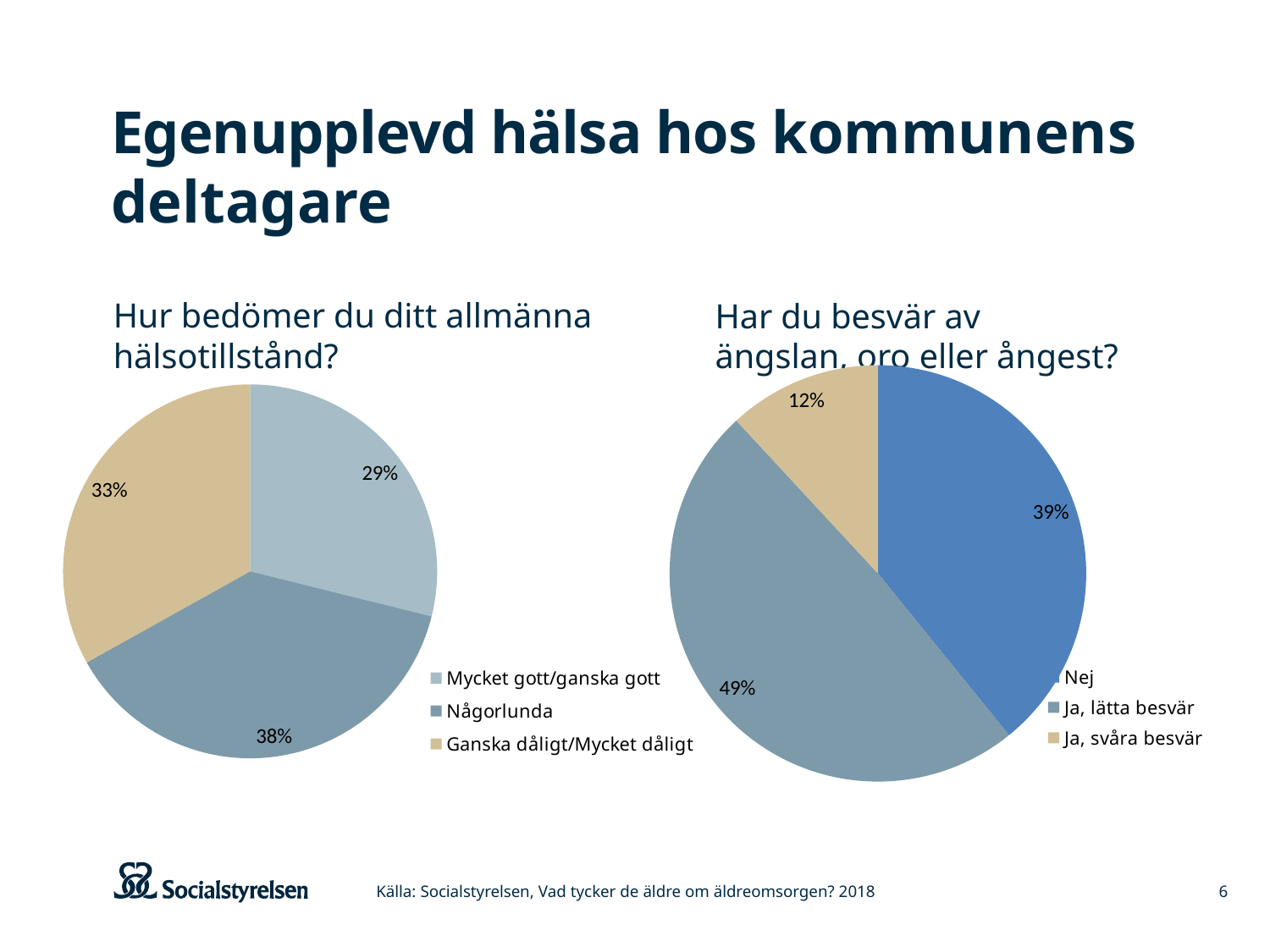
In the right chart (Har du besvär av ängslan, oro eller ångest?), what share of respondents answered Nej? 39% In the left chart (Hur bedömer du ditt allmänna hälsotillstånd?), what share of respondents answered Någorlunda? 38% In the right chart (Har du besvär av ängslan, oro eller ångest?), which is larger: the share for Nej or the share for Ja, lätta besvär? Ja, lätta besvär In the left chart (Hur bedömer du ditt allmänna hälsotillstånd?), which answer has the largest share? Någorlunda In the left chart (Hur bedömer du ditt allmänna hälsotillstånd?), what is the difference in percentage points between Någorlunda and Mycket gott/ganska gott? 9 percentage points In the left chart (Hur bedömer du ditt allmänna hälsotillstånd?), what share of respondents answered Ganska dåligt/Mycket dåligt? 33% What type of chart is used for the left chart (Hur bedömer du ditt allmänna hälsotillstånd?)? Pie chart In the left chart (Hur bedömer du ditt allmänna hälsotillstånd?), what share of respondents answered Mycket gott/ganska gott? 29% In the left chart (Hur bedömer du ditt allmänna hälsotillstånd?), which answer has the smallest share? Mycket gott/ganska gott In the right chart (Har du besvär av ängslan, oro eller ångest?), what share of respondents answered Ja, lätta besvär? 49% In the right chart (Har du besvär av ängslan, oro eller ångest?), what share of respondents answered Ja, svåra besvär? 12% In the right chart (Har du besvär av ängslan, oro eller ångest?), which answer has the smallest share? Ja, svåra besvär